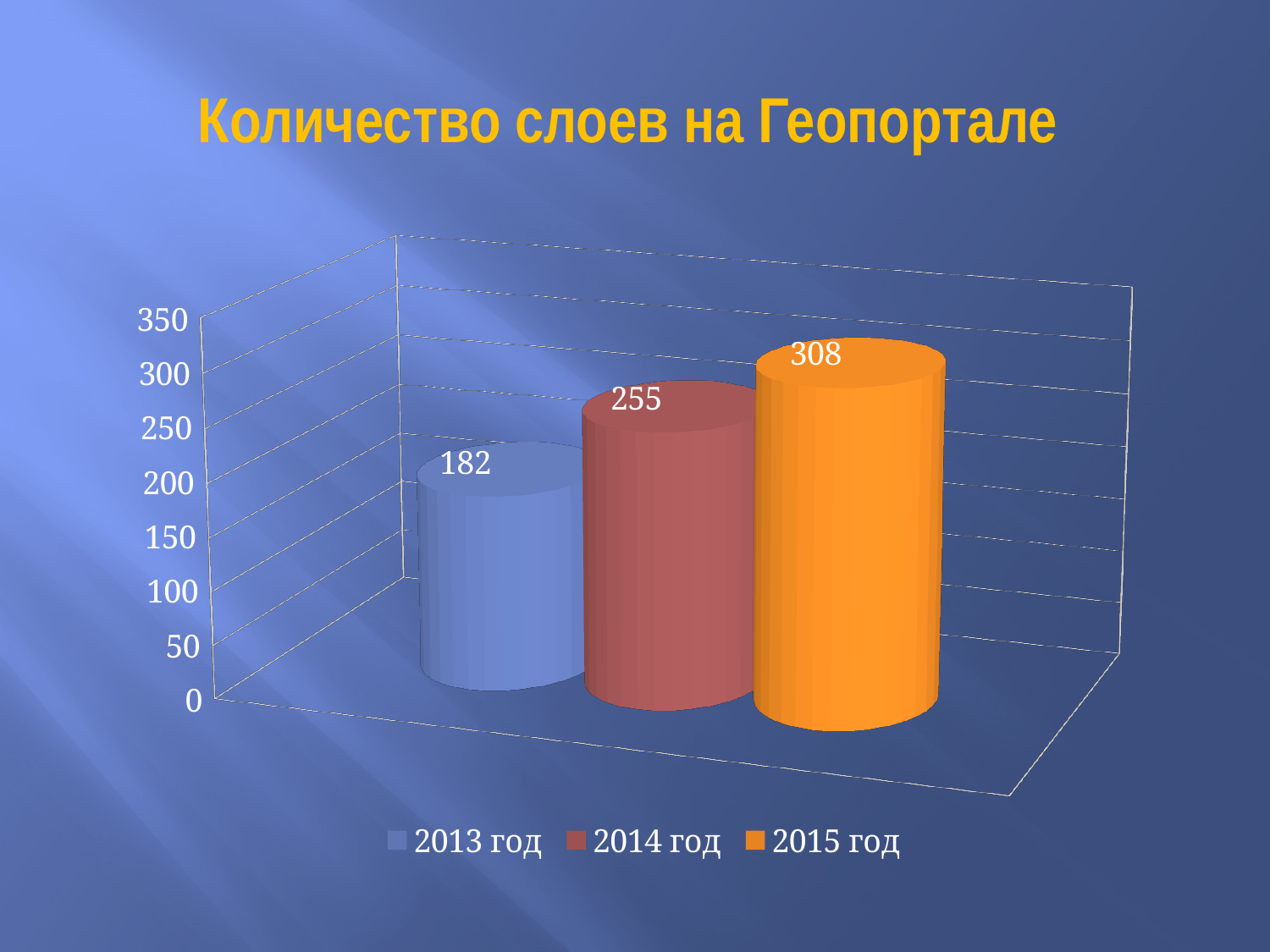
What kind of chart is shown on the slide? bar chart What is the value for 2014 год? 255 What is the title of the chart? Количество слоев на Геопортале What is the difference between the values for 2014 год and 2013 год? 73 Is the value for 2015 год greater or less than 300? greater Which year has the highest number of layers? 2015 год What is the value for 2013 год? 182 How many series does the legend list? 3 What is the difference between the values for 2015 год and 2013 год? 126 Which is larger, the value for 2014 год or the value for 2013 год? 2014 год What is the value for 2015 год? 308 Which year has the lowest number of layers? 2013 год